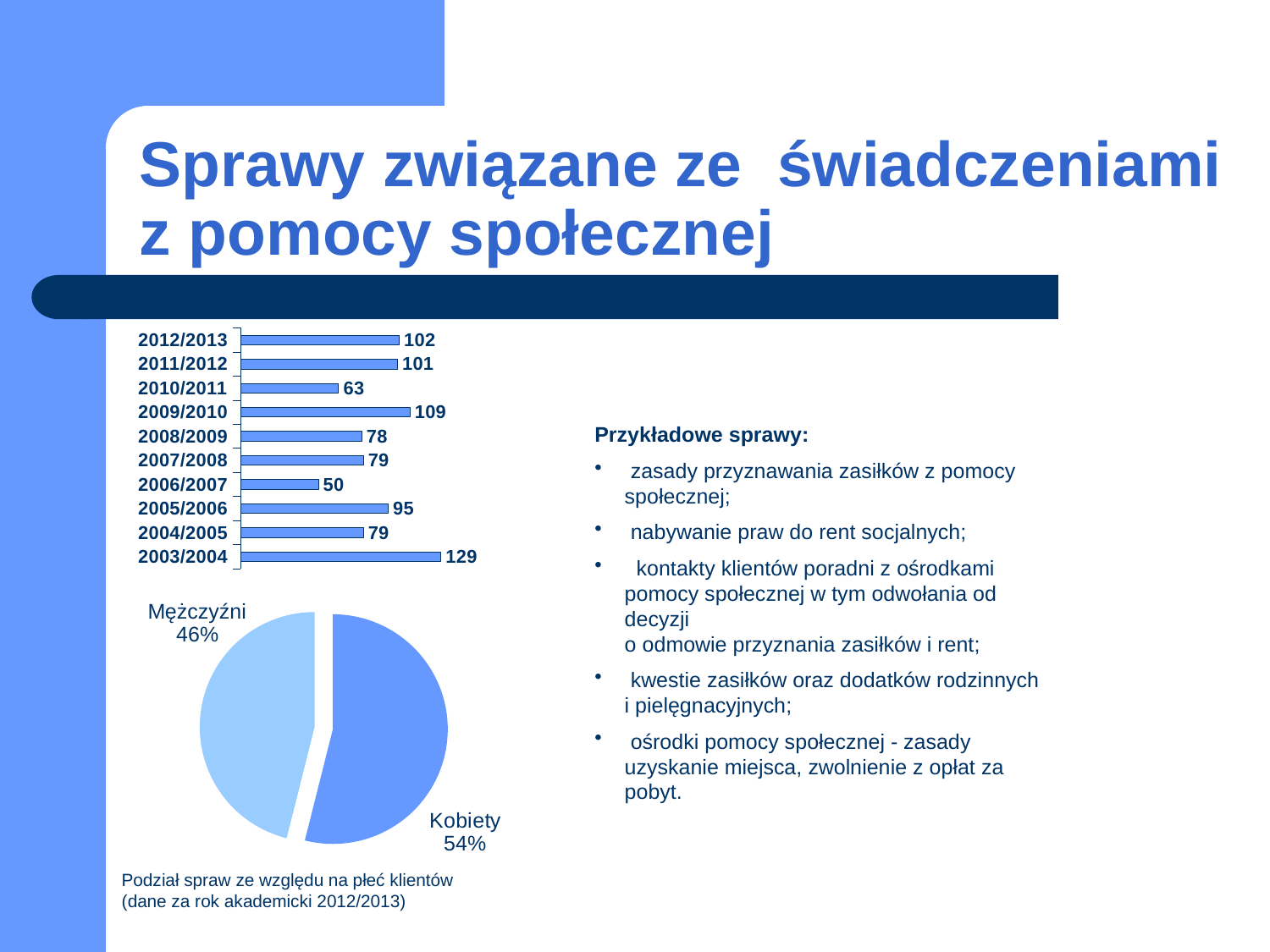
What type of chart is the chart at the bottom left of the slide? pie chart In the bar chart at the top left, what is the value for 2010/2011? 63 In the bar chart at the top left, which academic year has the highest value? 2003/2004 In the pie chart at the bottom left, what share is Kobiety? 54% In the pie chart at the bottom left, what share is Mężczyźni? 46% In the bar chart at the top left, what is the difference between the values for 2009/2010 and 2010/2011? 46 In the pie chart at the bottom left, which slice is larger, Kobiety or Mężczyźni? Kobiety In the bar chart at the top left, which academic year has the lowest value? 2006/2007 In the bar chart at the top left, how many academic years are shown? 10 In the bar chart at the top left, what is the value for 2003/2004? 129 What type of chart is the chart at the top left of the slide? bar chart In the bar chart at the top left, which is larger, the value for 2005/2006 or the value for 2008/2009? 2005/2006